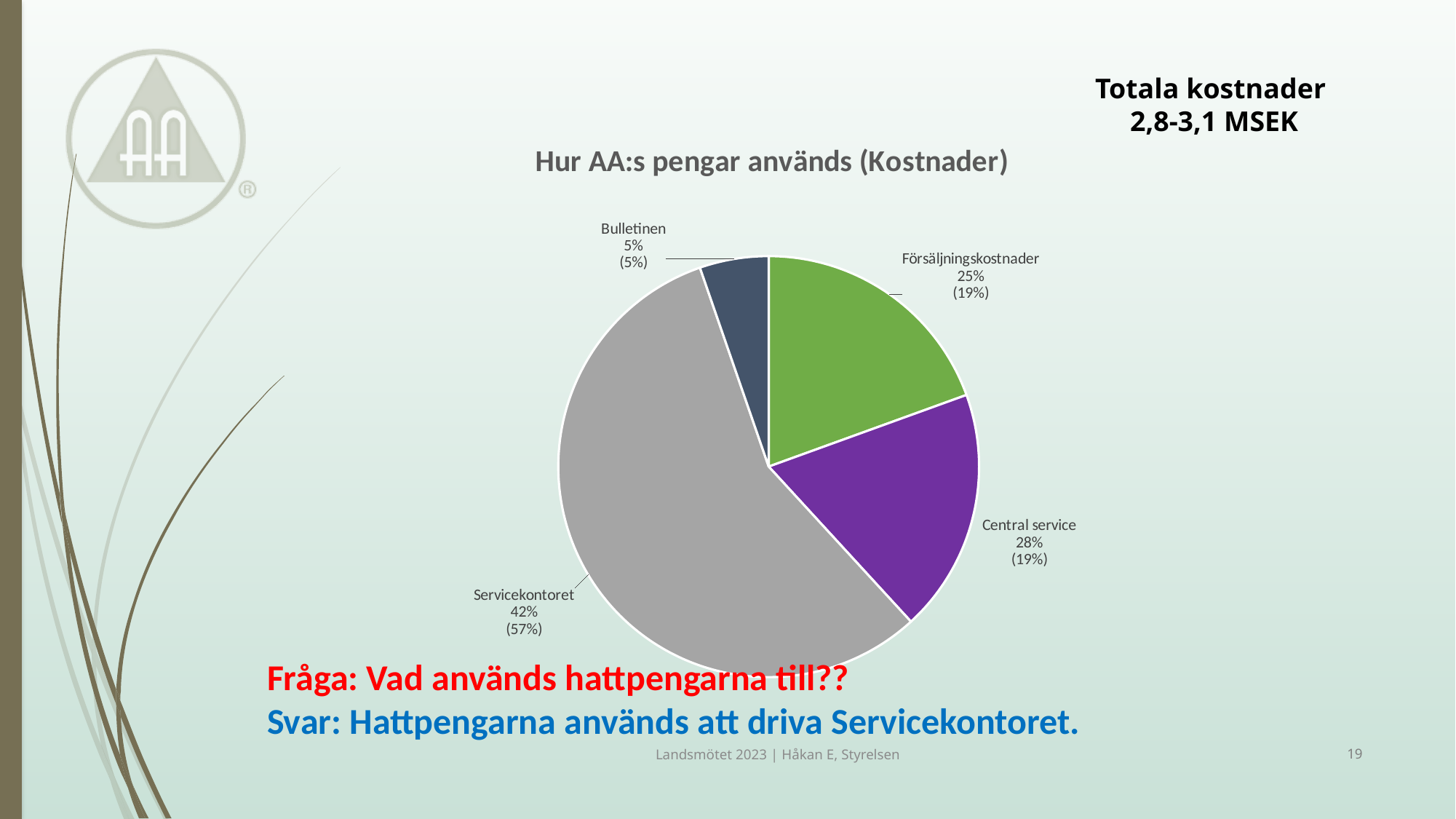
What share of the pie does Servicekontoret have? 57% What is the title of the chart? Hur AA:s pengar används (Kostnader) What value is shown in parentheses for Servicekontoret? (57%) What share of the pie does Central service have? 19% What share of the pie does Försäljningskostnader have? 19% Which category has the largest slice of the pie? Servicekontoret What kind of chart is shown on the slide? pie chart Which category has the smallest slice of the pie? Bulletinen How many slices does the pie chart have? 4